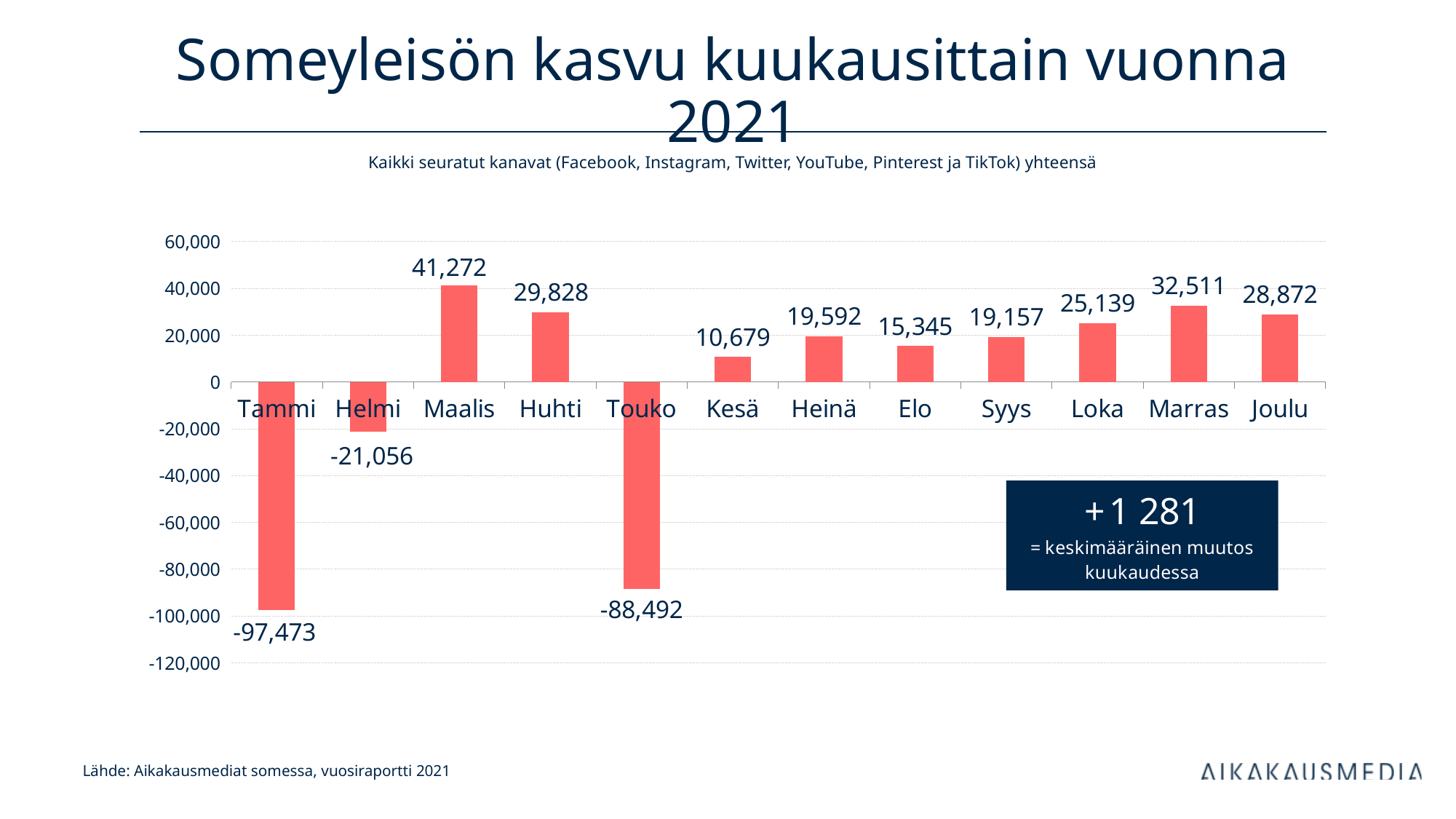
What kind of chart is this? Bar chart What is the value for Helmi? -21,056 How many months are shown on the x axis? 12 How many months have a negative value? 3 What is the value for Maalis? 41,272 Which month has the highest value? Maalis Which month has the lowest value? Tammi What is the difference between the values for Marras and Loka? 7,372 What average monthly change is shown in the box on the chart? +1 281 What is the value for Tammi? -97,473 What is the value for Joulu? 28,872 Which is larger, the value for Huhti or the value for Joulu? Huhti